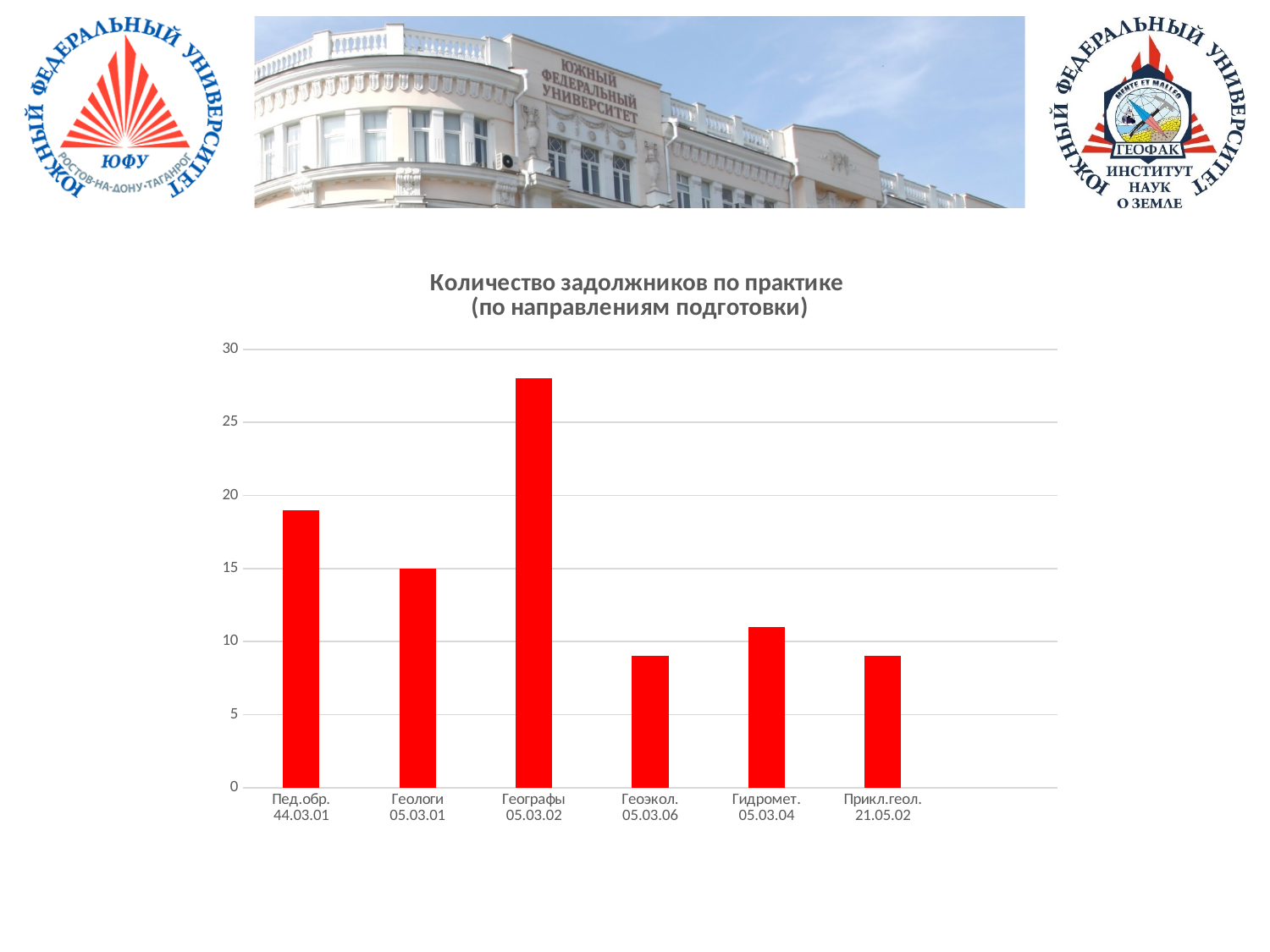
How many categories (направления подготовки) are shown on the x axis? 6 Is the value for Геоэкол. 05.03.06 greater or less than 10? less Which is larger, the value for Пед.обр. 44.03.01 or the value for Гидромет. 05.03.04? Пед.обр. 44.03.01 What is the value for Геологи 05.03.01? 15 What colour are the bars in the chart? red Which is larger, the value for Географы 05.03.02 or the value for Пед.обр. 44.03.01? Географы 05.03.02 Is the value for Географы 05.03.02 greater or less than 25? greater Which category has the highest number of задолжников? Географы 05.03.02 Is the value for Пед.обр. 44.03.01 greater or less than 20? less What type of chart is shown on the slide? bar chart What is the title of the chart? Количество задолжников по практике (по направлениям подготовки)